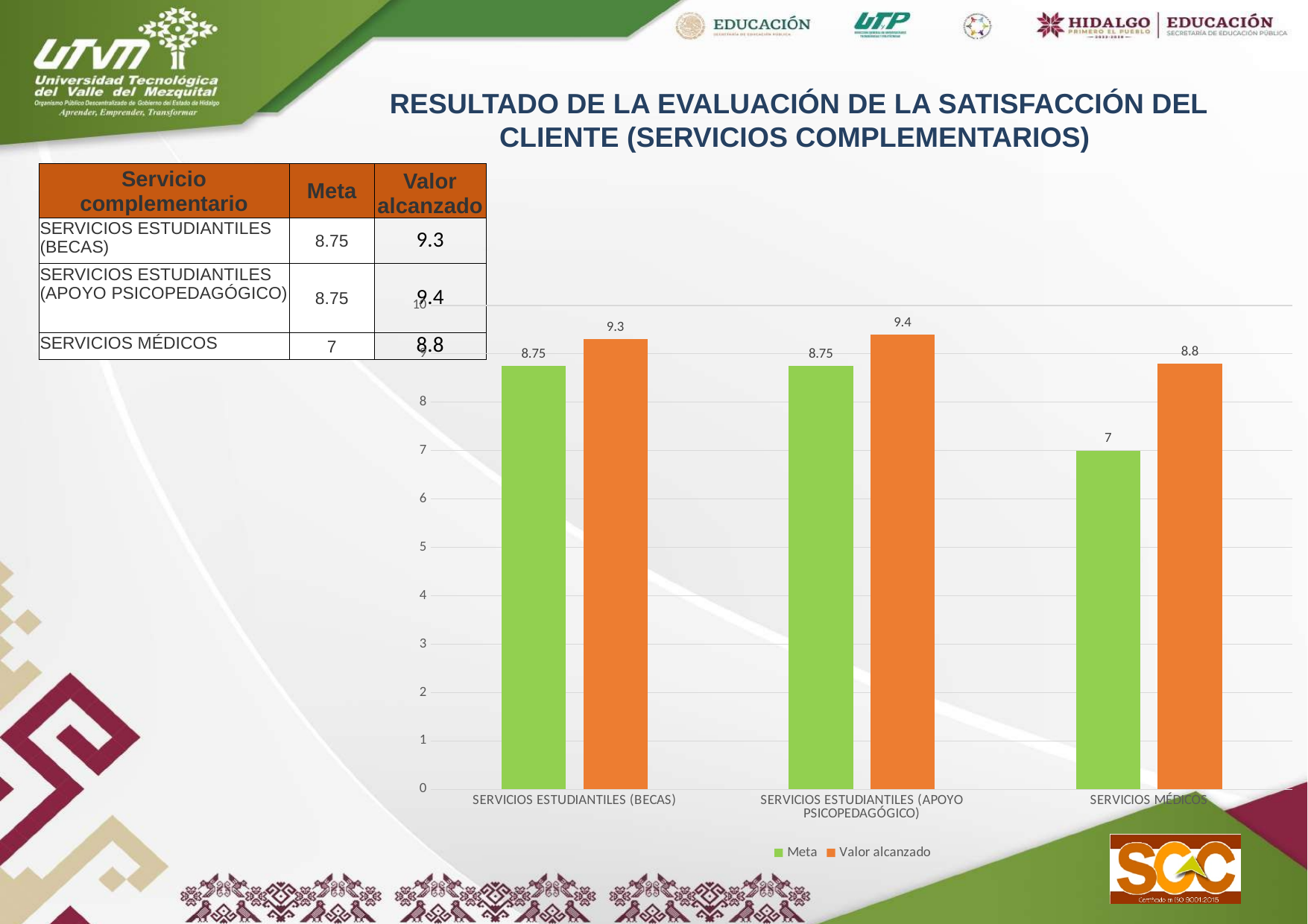
Which category has the lowest Meta value? SERVICIOS MÉDICOS Is the Meta value for SERVICIOS MÉDICOS greater or less than 8? less How many series does the chart legend list? 2 What is the Valor alcanzado value for SERVICIOS ESTUDIANTILES (APOYO PSICOPEDAGÓGICO)? 9.4 Which is larger for SERVICIOS ESTUDIANTILES (BECAS): the Meta or the Valor alcanzado? Valor alcanzado Which series is shown in orange in the chart? Valor alcanzado What is the difference between the Valor alcanzado and the Meta for SERVICIOS MÉDICOS? 1.8 What is the Valor alcanzado value for SERVICIOS ESTUDIANTILES (BECAS)? 9.3 How many categories are shown on the x axis of the chart? 3 What type of chart is shown on the slide? bar chart What is the Meta value for SERVICIOS MÉDICOS? 7 Which category has the highest Valor alcanzado? SERVICIOS ESTUDIANTILES (APOYO PSICOPEDAGÓGICO)